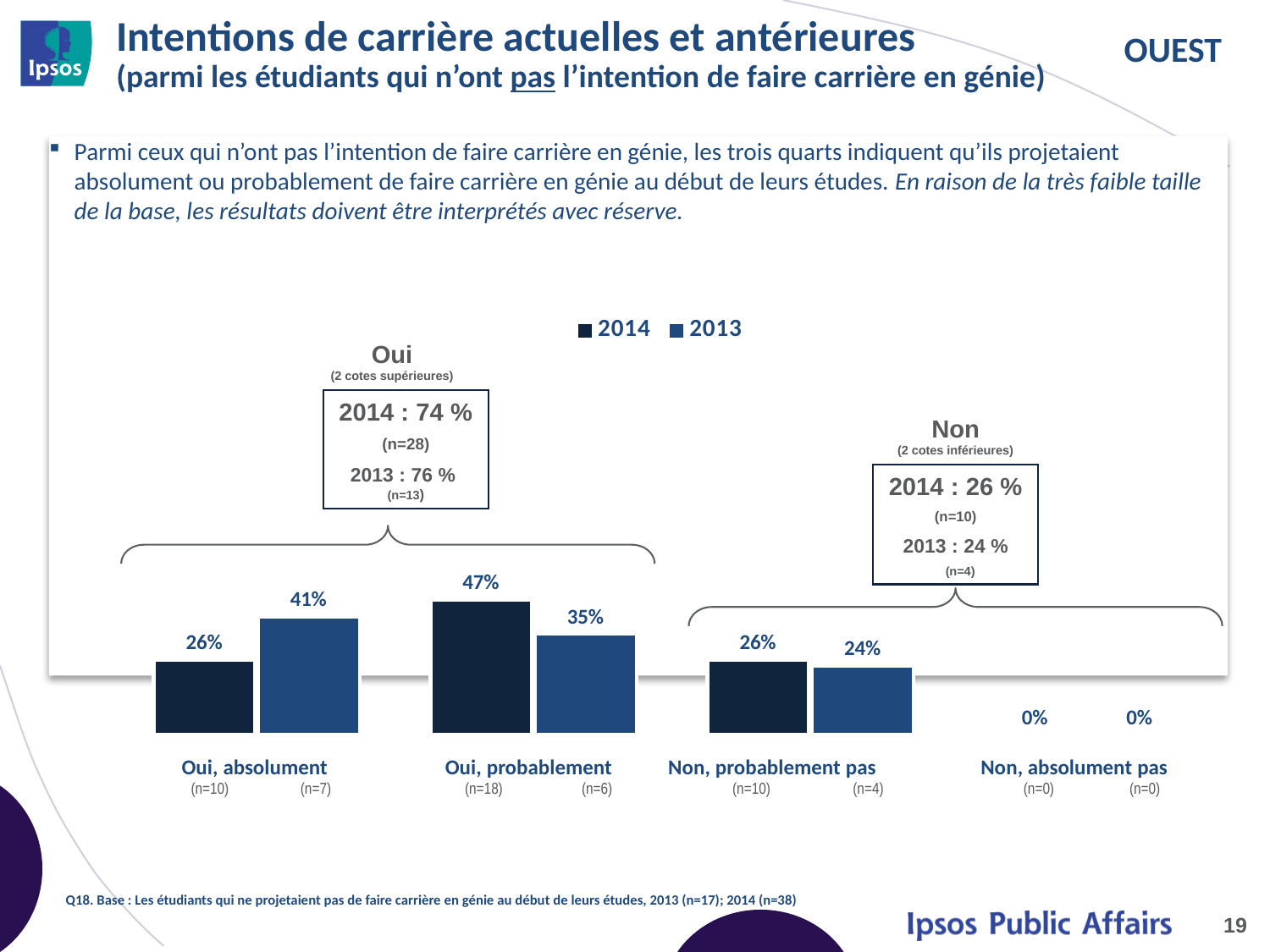
How many categories are shown on the x axis? 4 What is the difference between the 2014 and 2013 values for "Oui, probablement"? 12% How many series does the legend list? 2 For "Oui, absolument", which year has the larger value, 2014 or 2013? 2013 What is the 2014 value for "Non, absolument pas"? 0% Which category has the highest 2014 value? Oui, probablement What kind of chart is shown on the slide? Bar chart What is the 2013 value for "Non, probablement pas"? 24% What is the 2014 value for "Oui, probablement"? 47% What is the difference between the 2013 and 2014 values for "Oui, absolument"? 15% Which category has the lowest 2013 value? Non, absolument pas What is the 2013 value for "Oui, absolument"? 41%